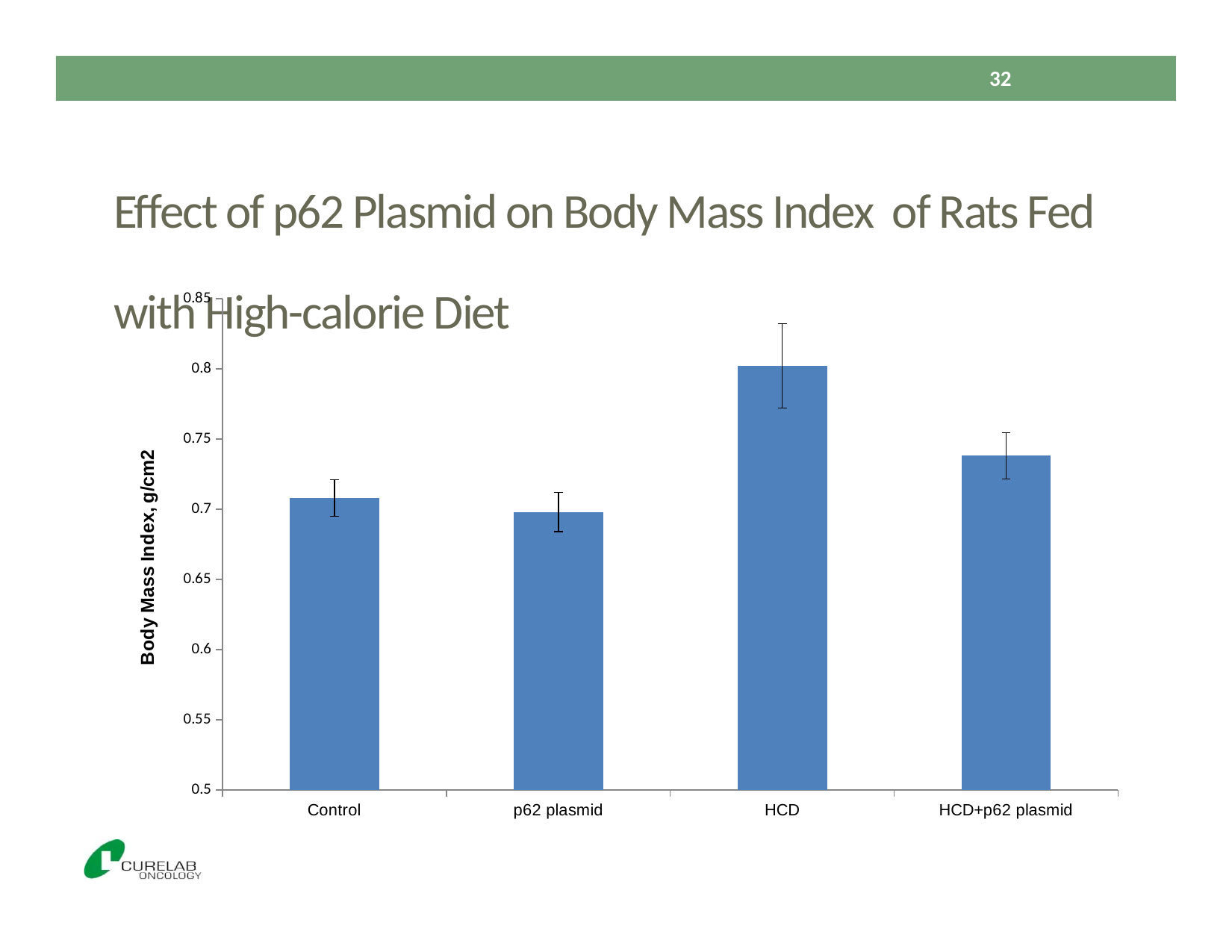
What kind of chart is shown on the slide? bar chart Which category has the highest Body Mass Index in the chart? HCD How many categories are plotted on the x axis of the chart? 4 What is the label of the y axis of the chart? Body Mass Index, g/cm2 Is the value for Control greater or less than 0.75? less Is the value for HCD+p62 plasmid greater or less than 0.75? less Which is larger, the value for HCD+p62 plasmid or the value for p62 plasmid? HCD+p62 plasmid Is the value for p62 plasmid greater or less than 0.65? greater Which is larger, the value for HCD or the value for HCD+p62 plasmid? HCD Which is larger, the value for HCD or the value for Control? HCD